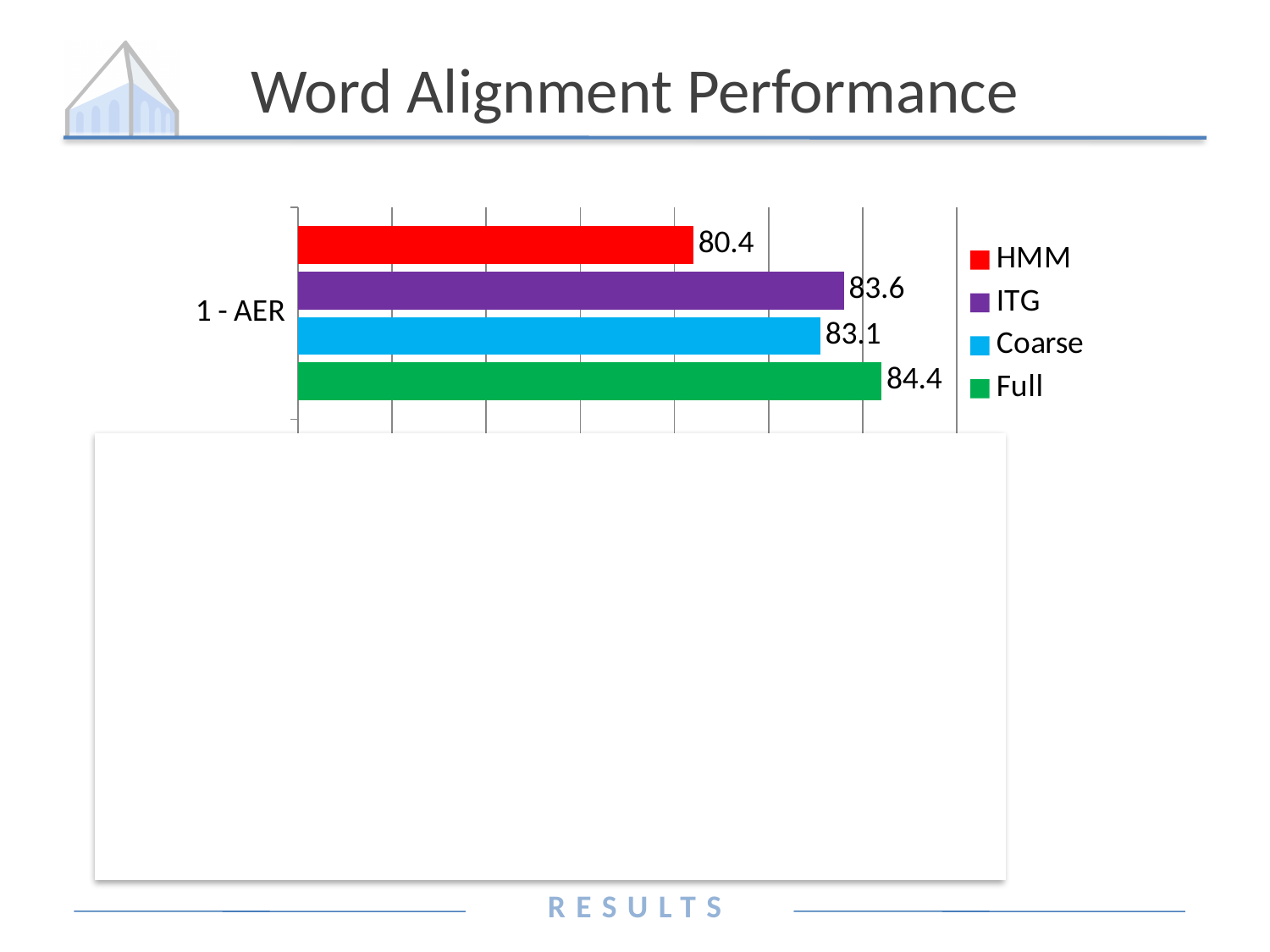
What is the 1 - AER value for Full? 84.4 What colour is the bar for Coarse? Blue Which is larger, the value for ITG or the value for Coarse? ITG What is the difference between the Full and HMM values? 4.0 How many series does the legend list? 4 Which series has the highest 1 - AER value? Full Which series has the lowest 1 - AER value? HMM What is the 1 - AER value for ITG? 83.6 What is the difference between the ITG and Coarse values? 0.5 What is the 1 - AER value for Coarse? 83.1 What is the 1 - AER value for HMM? 80.4 What kind of chart is shown on the slide? Bar chart